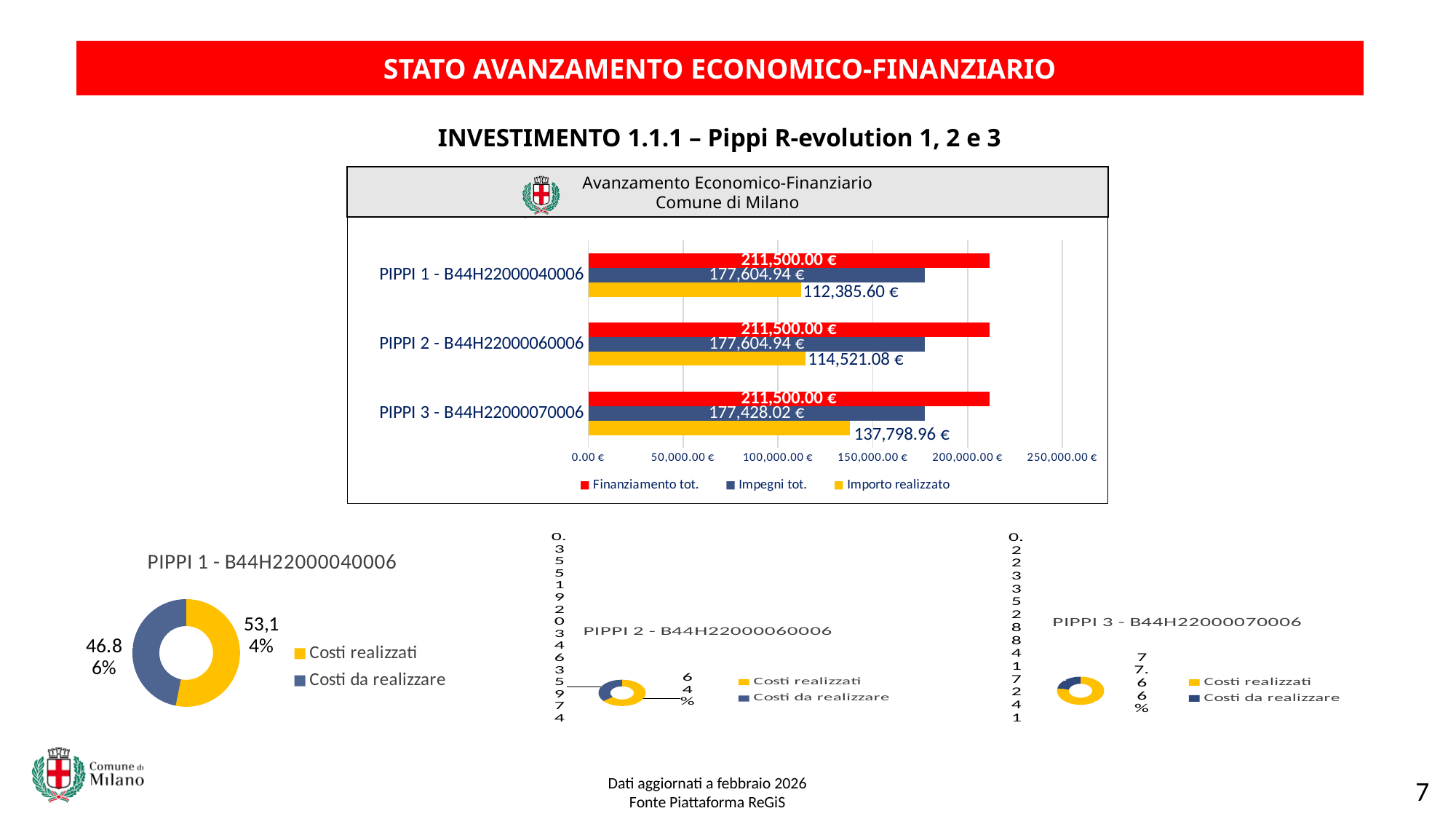
In the Avanzamento Economico-Finanziario bar chart, which project has the lowest Importo realizzato? PIPPI 1 - B44H22000040006 In the Avanzamento Economico-Finanziario bar chart, which project has the highest Importo realizzato? PIPPI 3 - B44H22000070006 How many series does the legend of the Avanzamento Economico-Finanziario bar chart list? 3 In the Avanzamento Economico-Finanziario bar chart, what is the Finanziamento tot. value for PIPPI 1 - B44H22000040006? 211,500.00 € In the Avanzamento Economico-Finanziario bar chart, which has the larger Impegni tot.: PIPPI 1 or PIPPI 3? PIPPI 1 - B44H22000040006 In the Avanzamento Economico-Finanziario bar chart, what is the Impegni tot. value for PIPPI 2 - B44H22000060006? 177,604.94 € How many projects (categories) are shown in the Avanzamento Economico-Finanziario bar chart? 3 What kind of chart is the Avanzamento Economico-Finanziario chart at the top of the slide? Bar chart In the Avanzamento Economico-Finanziario bar chart, what is the difference between the Importo realizzato of PIPPI 3 and that of PIPPI 1? 25,413.36 € In the PIPPI 1 - B44H22000040006 donut chart at the bottom left, what share is Costi realizzati? 53,14% In the Avanzamento Economico-Finanziario bar chart, how much larger is the Finanziamento tot. than the Impegni tot. for PIPPI 3 - B44H22000070006? 34,071.98 € In the Avanzamento Economico-Finanziario bar chart, what is the Importo realizzato for PIPPI 3 - B44H22000070006? 137,798.96 €